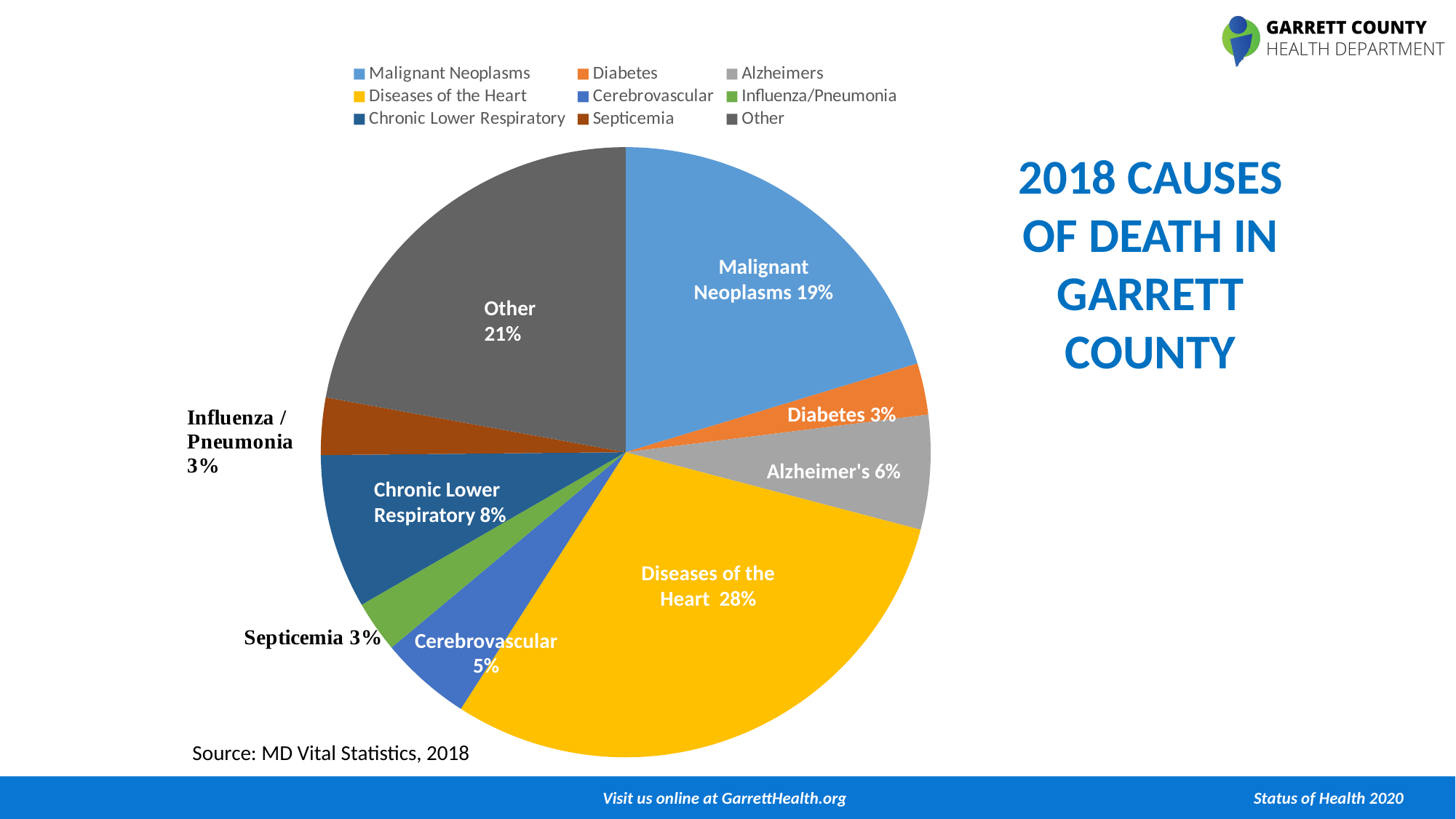
What share of the pie is labelled Chronic Lower Respiratory? 8% What share of deaths is attributed to Diseases of the Heart? 28% What percentage is shown for Cerebrovascular? 5% What is the source cited below the chart? MD Vital Statistics, 2018 Which named cause of death (excluding Other) has the largest slice? Diseases of the Heart How many entries does the legend list? 9 What kind of chart is shown on the slide? pie chart What percentage is shown for Alzheimer's? 6% What percentage of deaths is attributed to Malignant Neoplasms? 19% What is the difference in percentage points between Diseases of the Heart and Malignant Neoplasms? 9 How many slices does the pie chart have? 9 Which is larger, the share for Chronic Lower Respiratory or the share for Cerebrovascular? Chronic Lower Respiratory